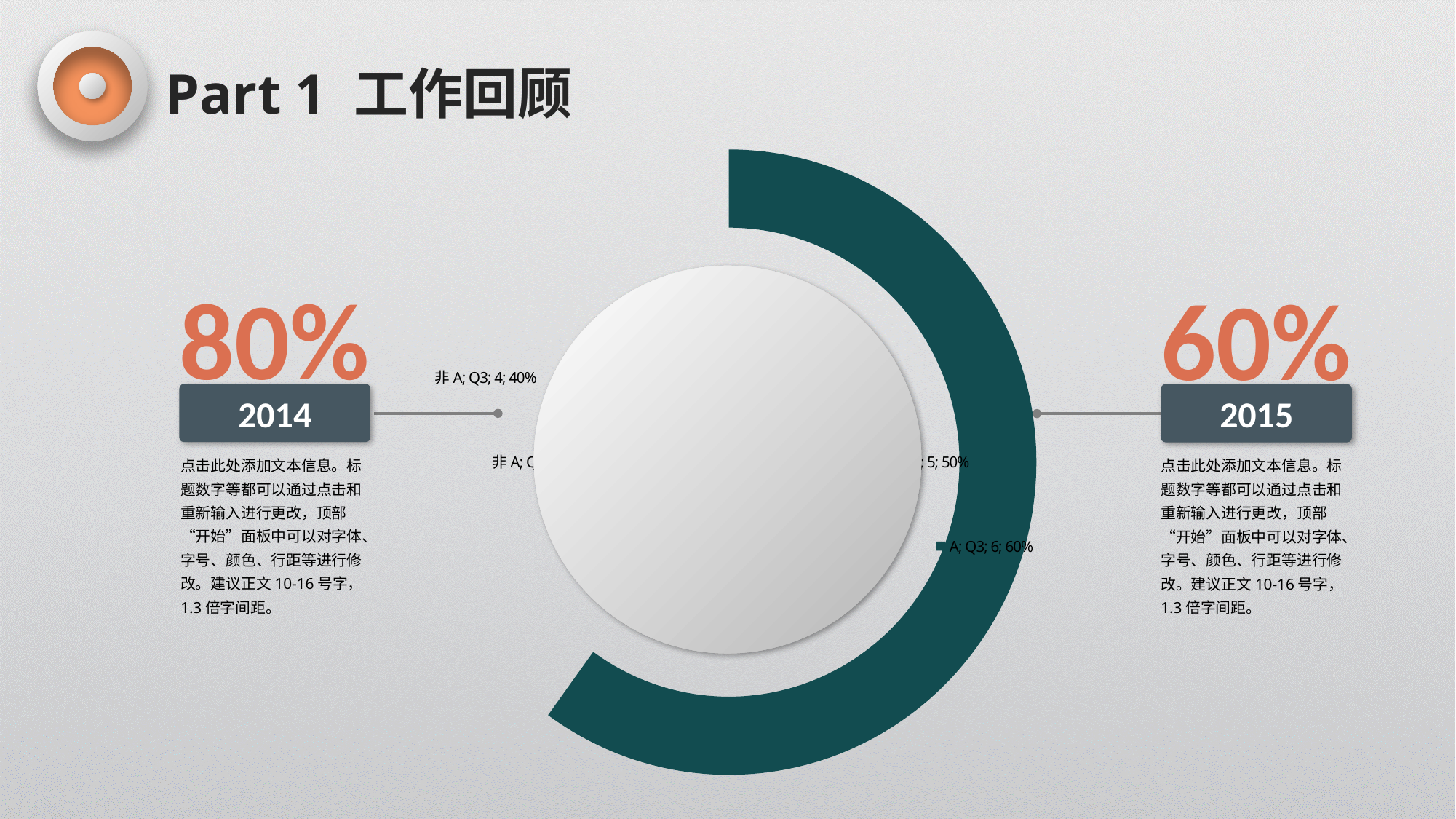
What colour is the ring of the doughnut chart? dark teal What is the difference between the percentages labelled for "A; Q3" and "非 A; Q3"? 20% What value is shown in the data label for "A; Q3" before the percentage? 6 What percentage is shown in the data label for "A; Q3"? 60% Which has the larger percentage in its data label, "A; Q3" or "非 A; Q3"? A; Q3 What value is shown in the data label for "非 A; Q3" before the percentage? 4 What percentage is shown in the data label for "非 A; Q3"? 40% What kind of chart is shown in the centre of the slide? doughnut chart